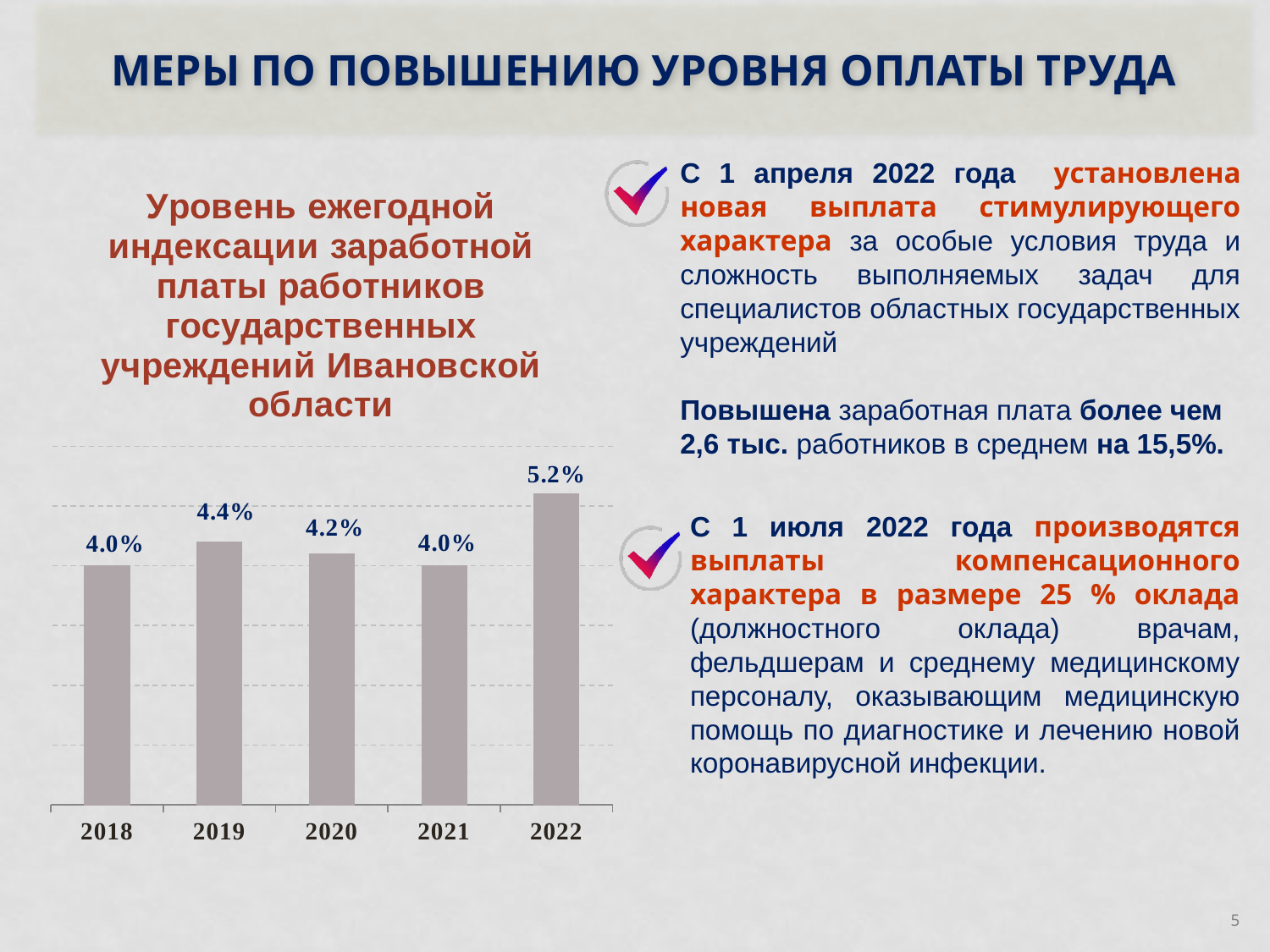
What is the value for 2018? 4.0% What is the value for 2020? 4.2% What is the value for 2019? 4.4% Which is larger, the value for 2019 or the value for 2020? 2019 What is the difference between the values for 2022 and 2021? 1.2% Which year has the highest value? 2022 Do the values rise or fall from 2021 to 2022? rise How many years are shown on the chart? 5 What is the title of the chart? Уровень ежегодной индексации заработной платы работников государственных учреждений Ивановской области What kind of chart is shown on the slide? bar chart What is the difference between the values for 2019 and 2020? 0.2% What is the value for 2022? 5.2%